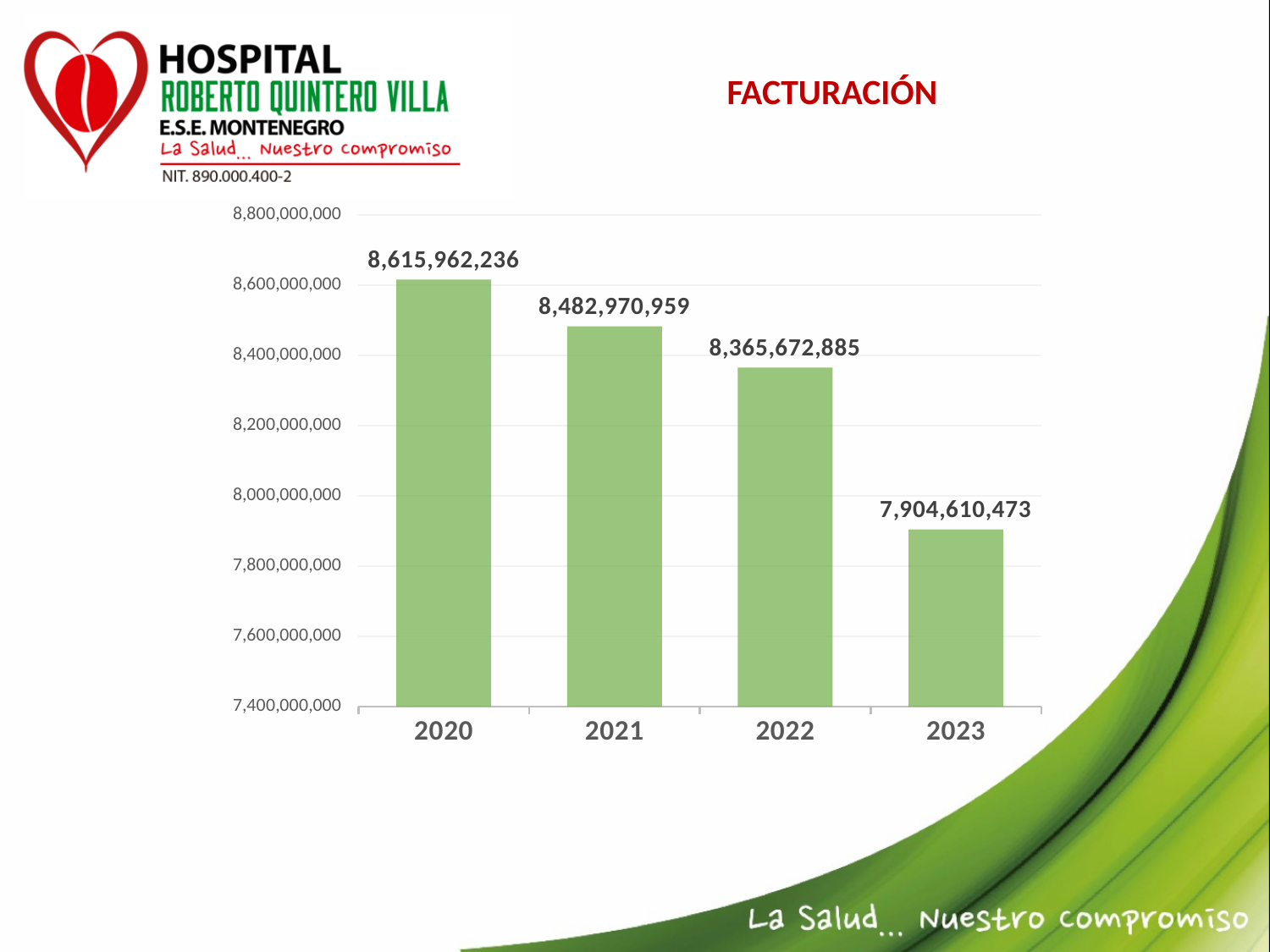
What is the value for 2023? 7,904,610,473 Which is larger, the value for 2021 or the value for 2022? 2021 What is the value for 2020? 8,615,962,236 Do the values rise or fall from 2020 to 2023? fall How many years are shown on the chart? 4 Which year has the highest value? 2020 What is the value for 2021? 8,482,970,959 What is the value for 2022? 8,365,672,885 What is the difference between the values for 2020 and 2021? 132,991,277 What is the difference between the values for 2022 and 2023? 461,062,412 Which year has the lowest value? 2023 Is the value for 2023 greater or less than 8,000,000,000? less